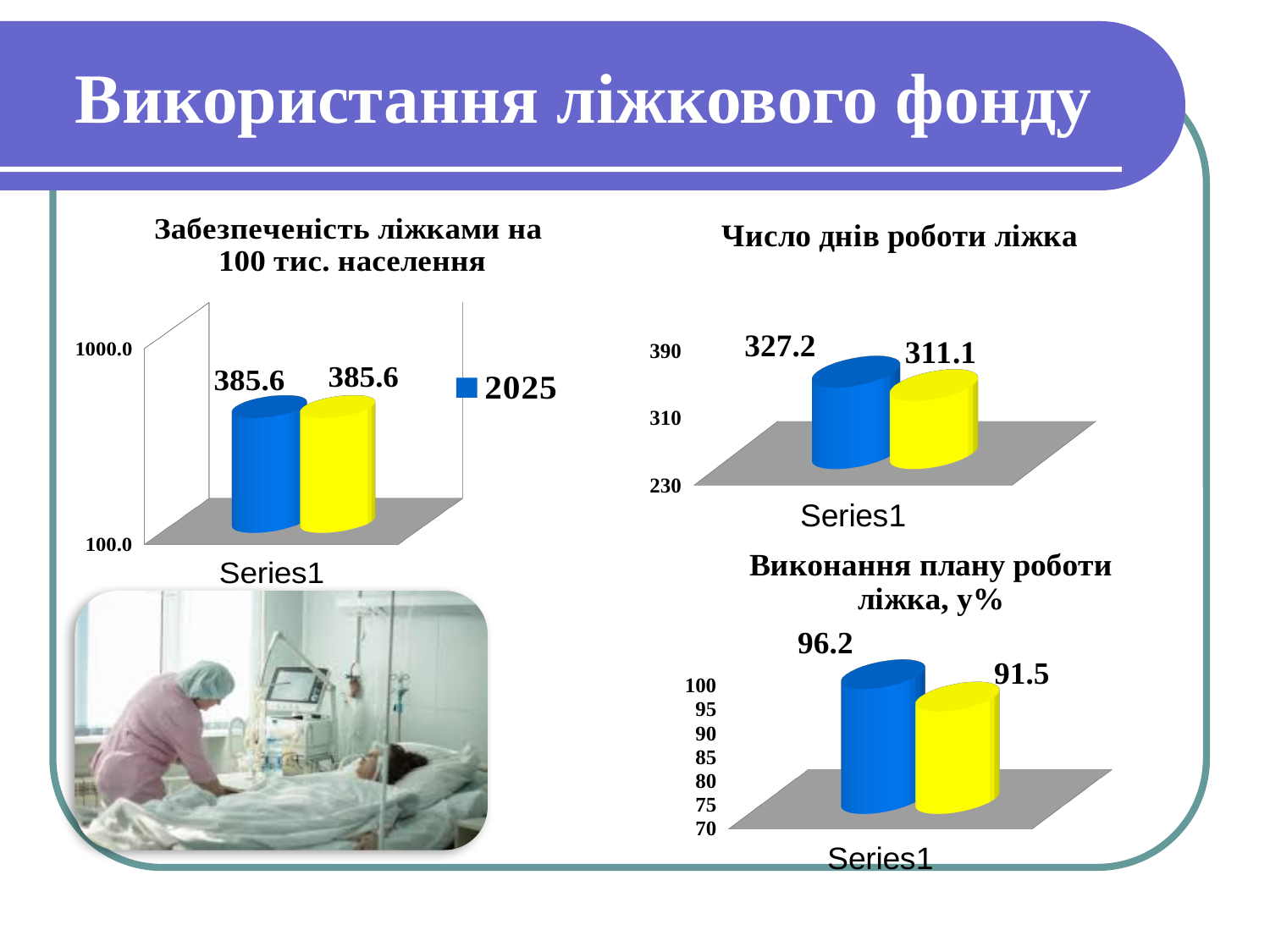
In the chart titled "Виконання плану роботи ліжка, у%", what is the difference between the blue bar and the yellow bar? 4.7 In the chart titled "Число днів роботи ліжка", which bar is larger, the blue one or the yellow one? the blue bar In the chart titled "Число днів роботи ліжка", what is the difference between the blue bar and the yellow bar? 16.1 In the chart titled "Забезпеченість ліжками на 100 тис. населення", what entry does the legend show? 2025 How many bars are plotted in the chart titled "Число днів роботи ліжка"? 2 In the chart titled "Забезпеченість ліжками на 100 тис. населення", what is the value of the blue bar? 385.6 In the chart titled "Виконання плану роботи ліжка, у%", what is the value of the blue bar? 96.2 In the chart titled "Виконання плану роботи ліжка, у%", what is the value of the yellow bar? 91.5 In the chart titled "Виконання плану роботи ліжка, у%", which bar is the highest? the blue bar In the chart titled "Число днів роботи ліжка", what is the value of the blue bar? 327.2 In the chart titled "Число днів роботи ліжка", what is the value of the yellow bar? 311.1 What kind of chart is the one titled "Число днів роботи ліжка"? bar chart